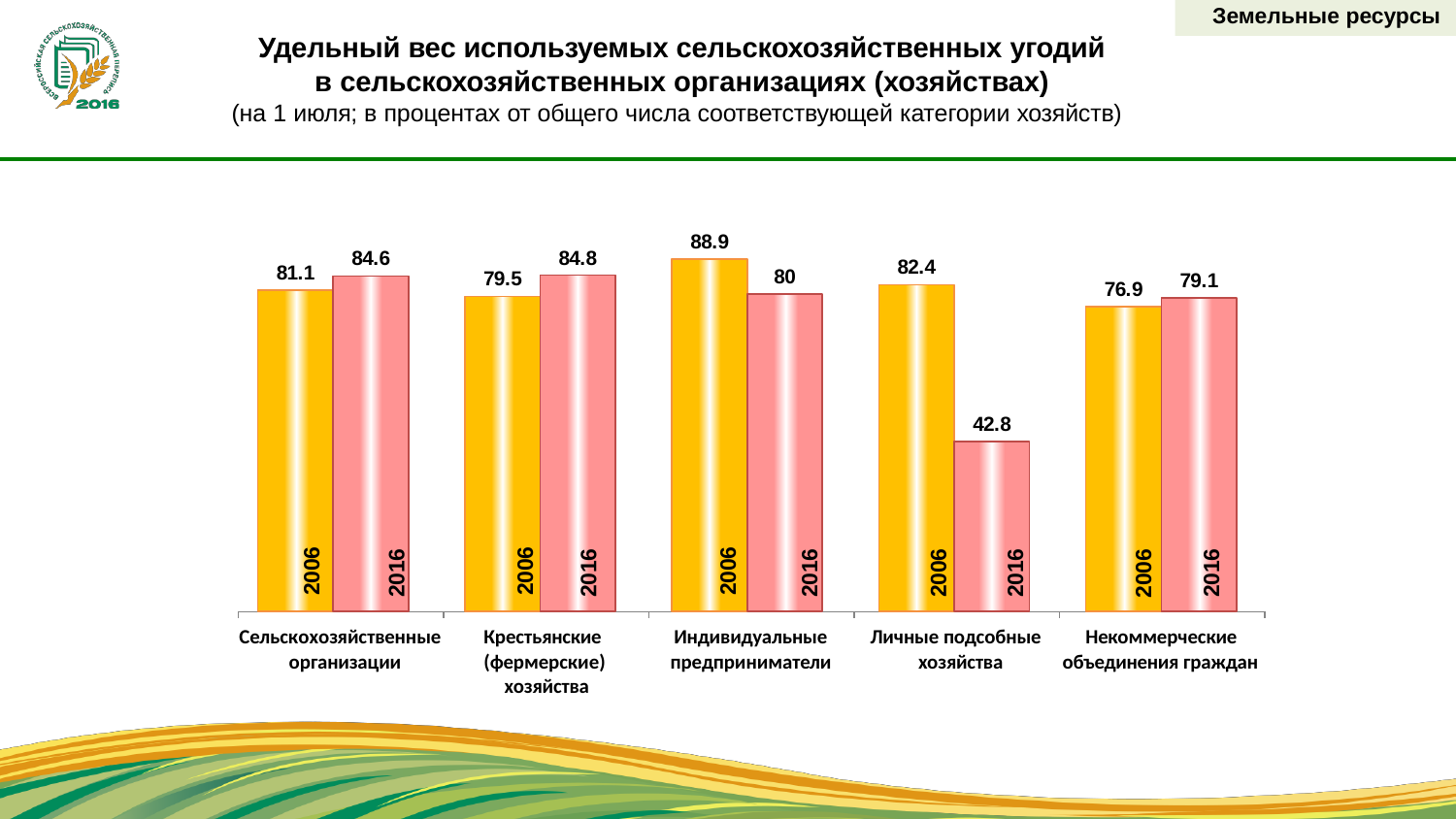
How many categories of farms are shown on the x axis? 5 What is the difference between the 2006 and 2016 values for Личные подсобные хозяйства? 39.6 What is the value for Некоммерческие объединения граждан in 2006? 76.9 What is the value for Индивидуальные предприниматели in 2016? 80 What is the value for Личные подсобные хозяйства in 2016? 42.8 Which category has the highest value in 2006? Индивидуальные предприниматели Which category has the lowest value in 2016? Личные подсобные хозяйства What is the difference between the 2016 and 2006 values for Крестьянские (фермерские) хозяйства? 5.3 How many years are compared for each category? 2 What kind of chart is shown on the slide? bar chart What is the value for Сельскохозяйственные организации in 2006? 81.1 Which is larger for Индивидуальные предприниматели: the 2006 value or the 2016 value? 2006